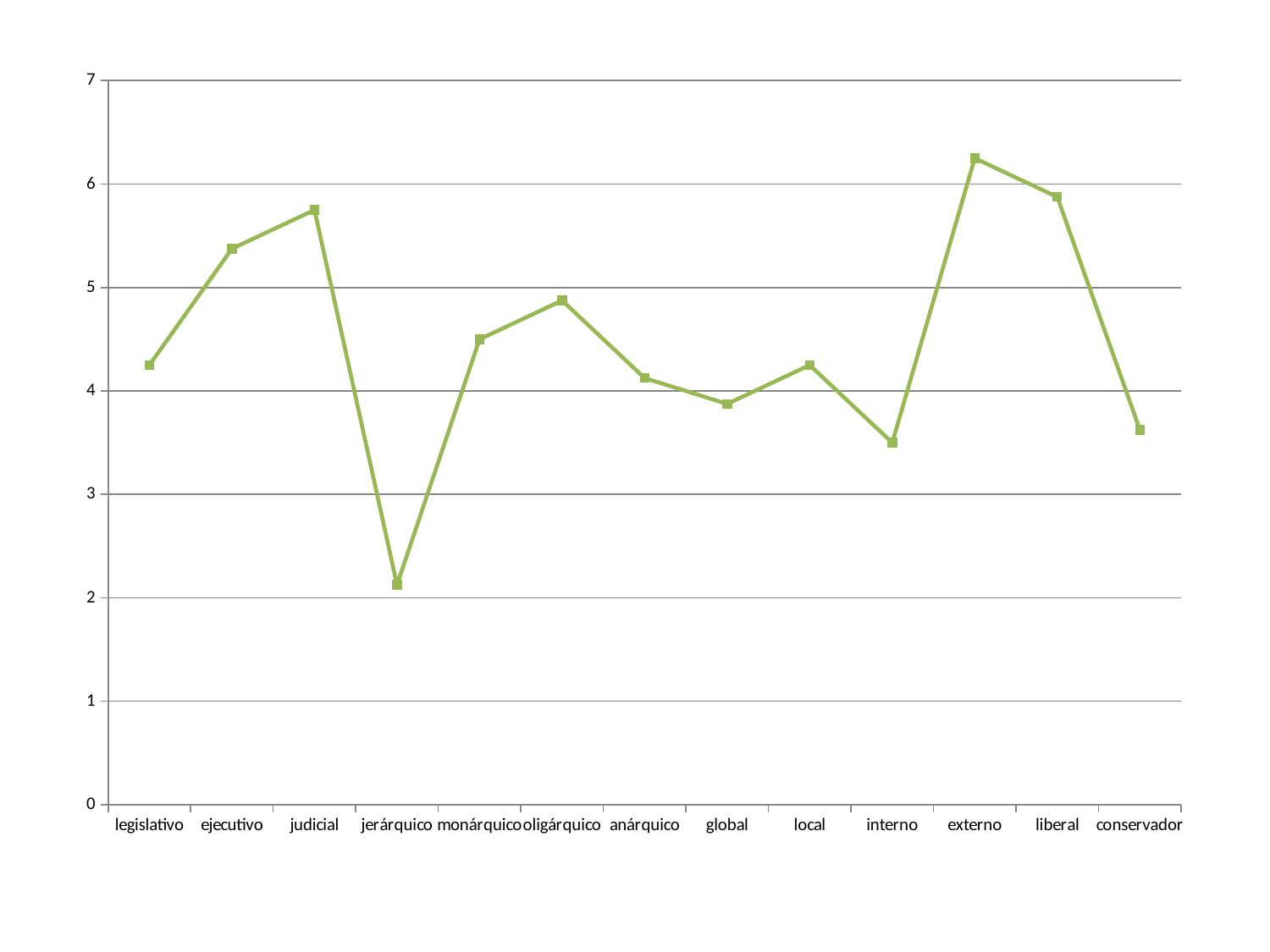
How many categories are plotted along the x axis? 13 Does the line rise or fall from legislativo to judicial? rise Which has a larger value, ejecutivo or global? ejecutivo Which has a larger value, conservador or liberal? liberal Is the value for jerárquico greater or less than 3? less Is the value for interno greater or less than 4? less Does the line rise or fall from externo to conservador? fall Is the value for externo greater or less than 6? greater Which category has the lowest value? jerárquico What kind of chart is shown on the slide? line chart Which category has the highest value? externo